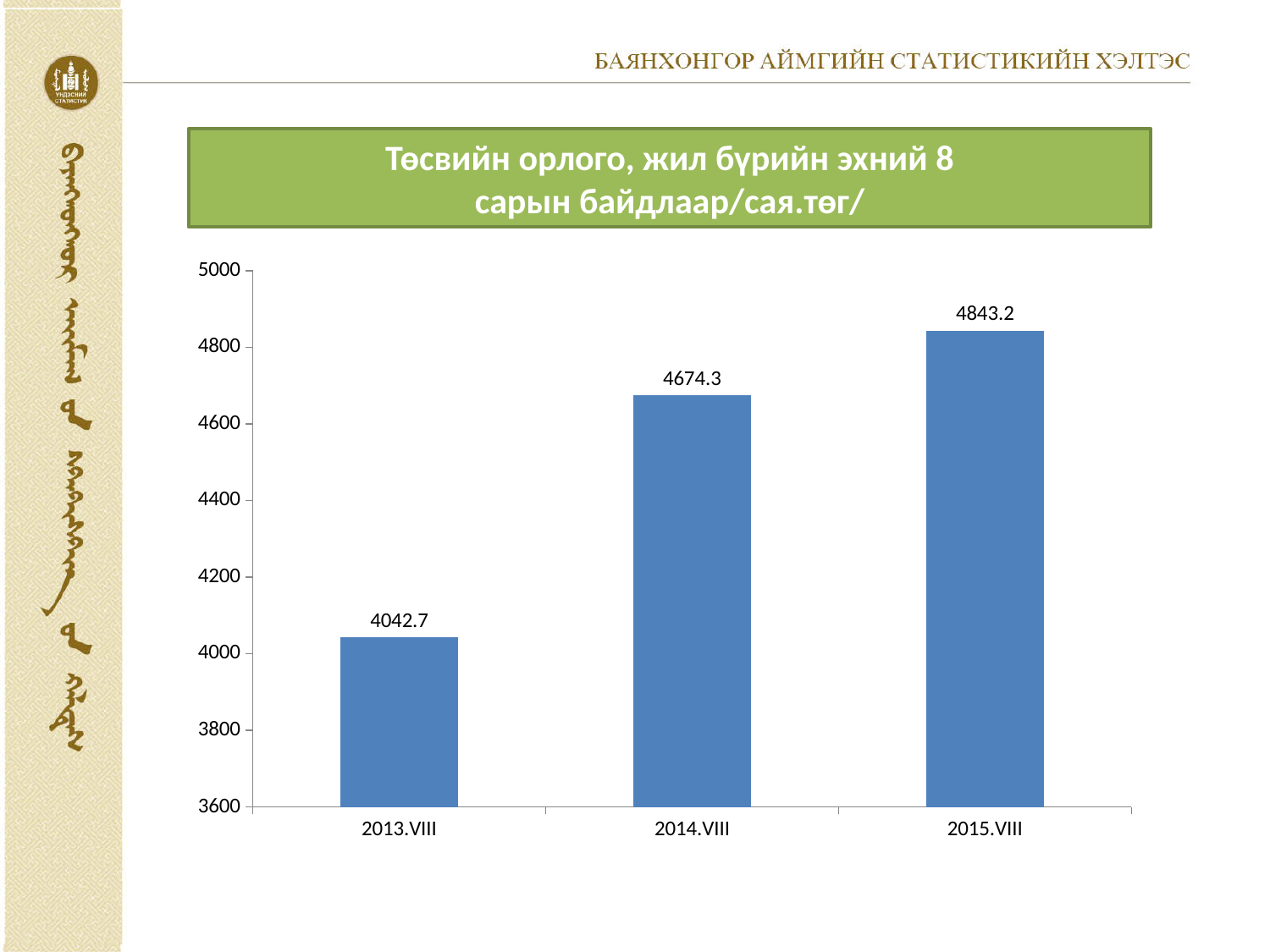
Which category has the lowest value? 2013.VIII Do the values rise or fall from 2013.VIII to 2015.VIII? rise Is the value for 2015.VIII greater or less than 4800? greater Which is larger, the value for 2013.VIII or the value for 2014.VIII? 2014.VIII What is the value for 2013.VIII? 4042.7 How many categories are shown on the x axis? 3 What is the difference between the values for 2014.VIII and 2013.VIII? 631.6 What kind of chart is shown on the slide? bar chart What is the value for 2014.VIII? 4674.3 What is the difference between the values for 2015.VIII and 2014.VIII? 168.9 What is the value for 2015.VIII? 4843.2 Which category has the highest value? 2015.VIII